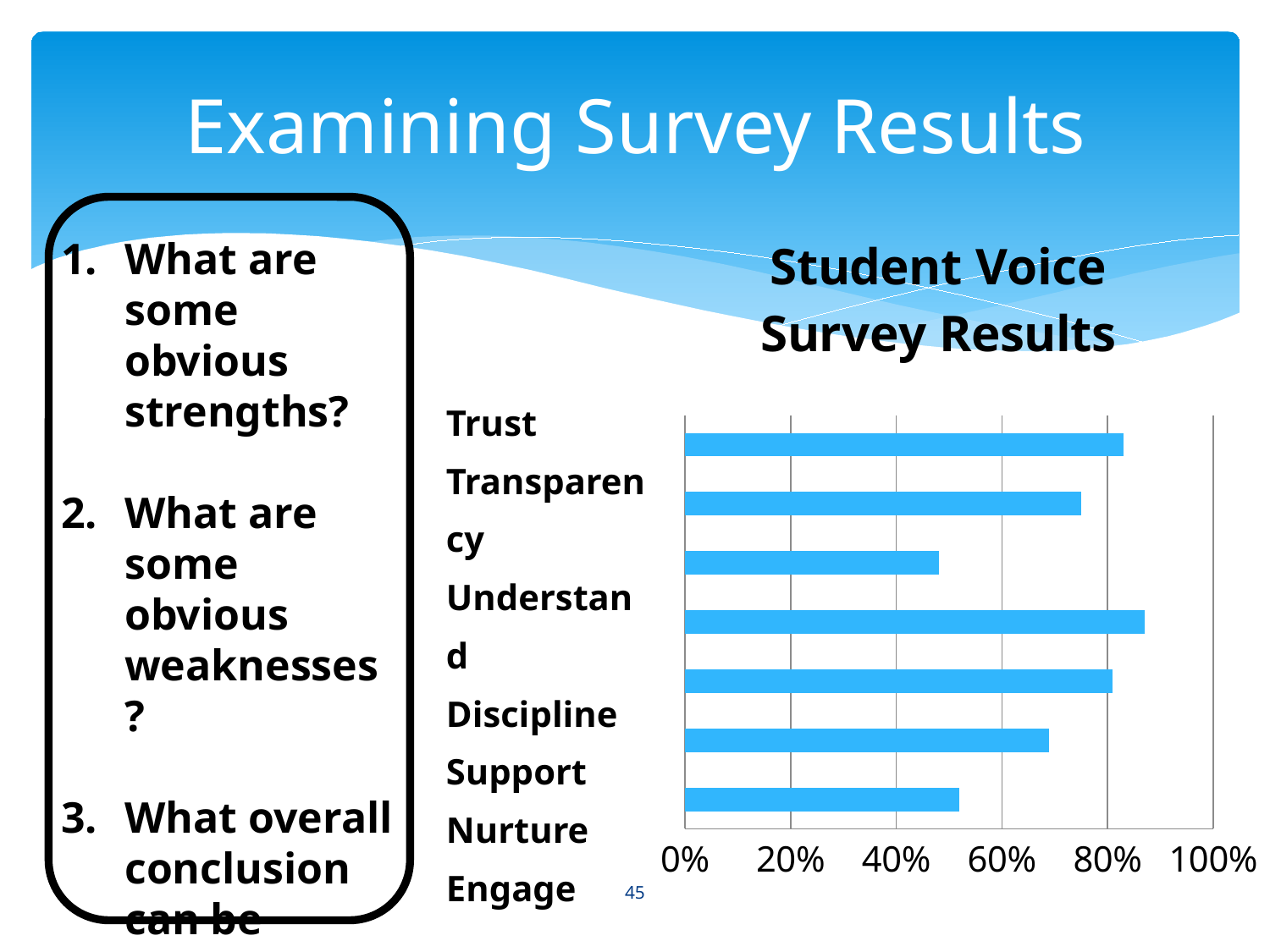
How many category labels are listed on the Student Voice Survey Results chart? 7 Which bar in the Student Voice Survey Results chart is the longest? the fourth bar from the top In the Student Voice Survey Results chart, is the value of the fourth bar from the top greater or less than 80%? greater In the Student Voice Survey Results chart, is the value of the sixth bar from the top greater or less than 80%? less What is the title of the chart on the slide? Student Voice Survey Results What is the highest value shown on the horizontal axis of the chart? 100% How many bars are plotted in the Student Voice Survey Results chart? 7 In the Student Voice Survey Results chart, which is larger: the top bar or the second bar from the top? the top bar What kind of chart is shown on the slide? bar chart In the Student Voice Survey Results chart, is the value of the third bar from the top greater or less than 60%? less